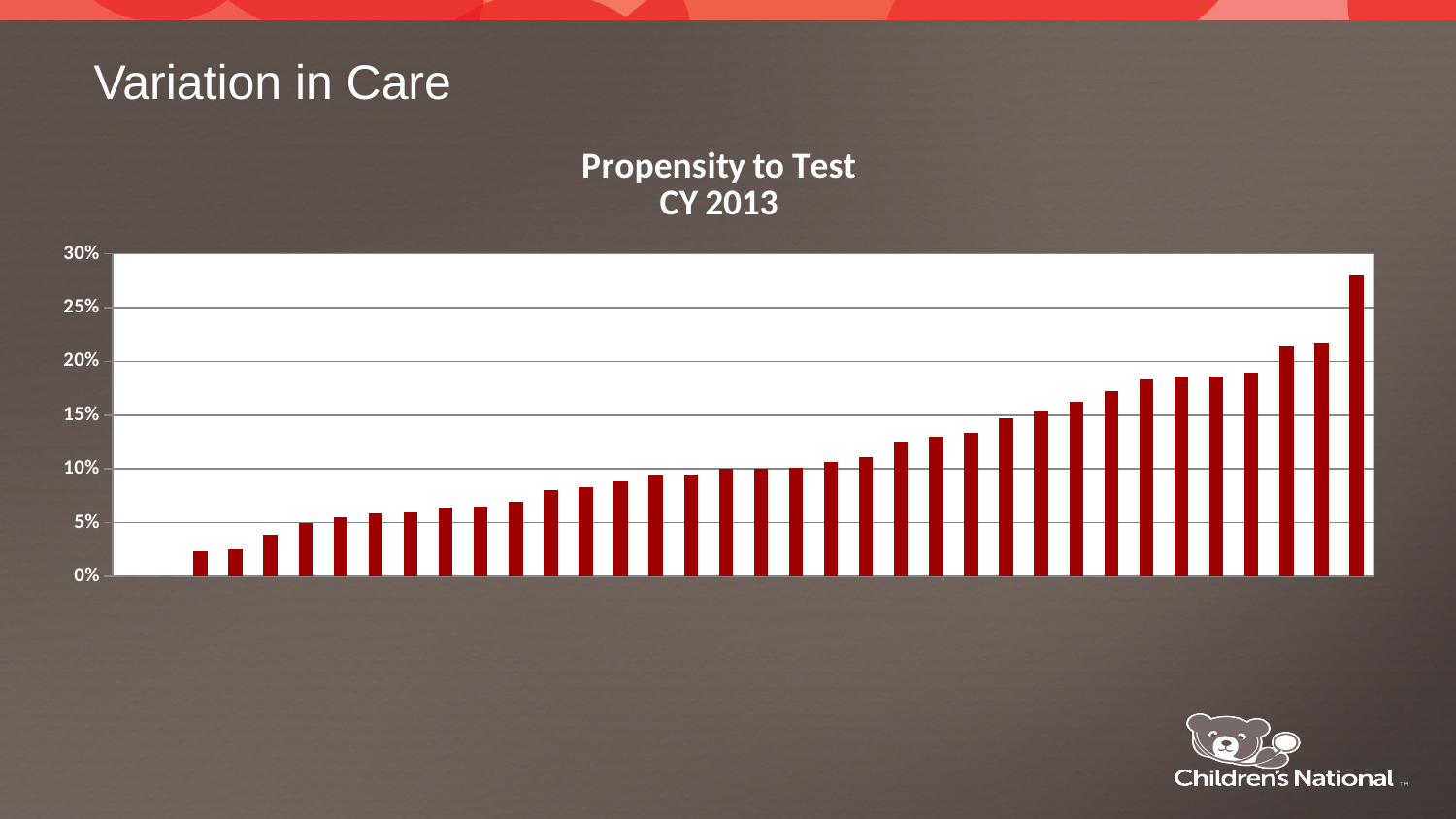
What is the title of the chart? Propensity to Test CY 2013 Is the value of the leftmost bar greater or less than 5%? less Do the bar values rise or fall from left to right across the chart? Rise Where on the chart is the shortest bar located? At the far left Is the value of the tallest bar greater or less than 25%? greater Is the rightmost bar taller or shorter than the leftmost bar? Taller Is the value of the second-tallest bar greater or less than 25%? less What kind of chart is shown on the slide? Bar chart What is the highest value shown on the vertical axis? 30% Where on the chart is the tallest bar located? At the far right